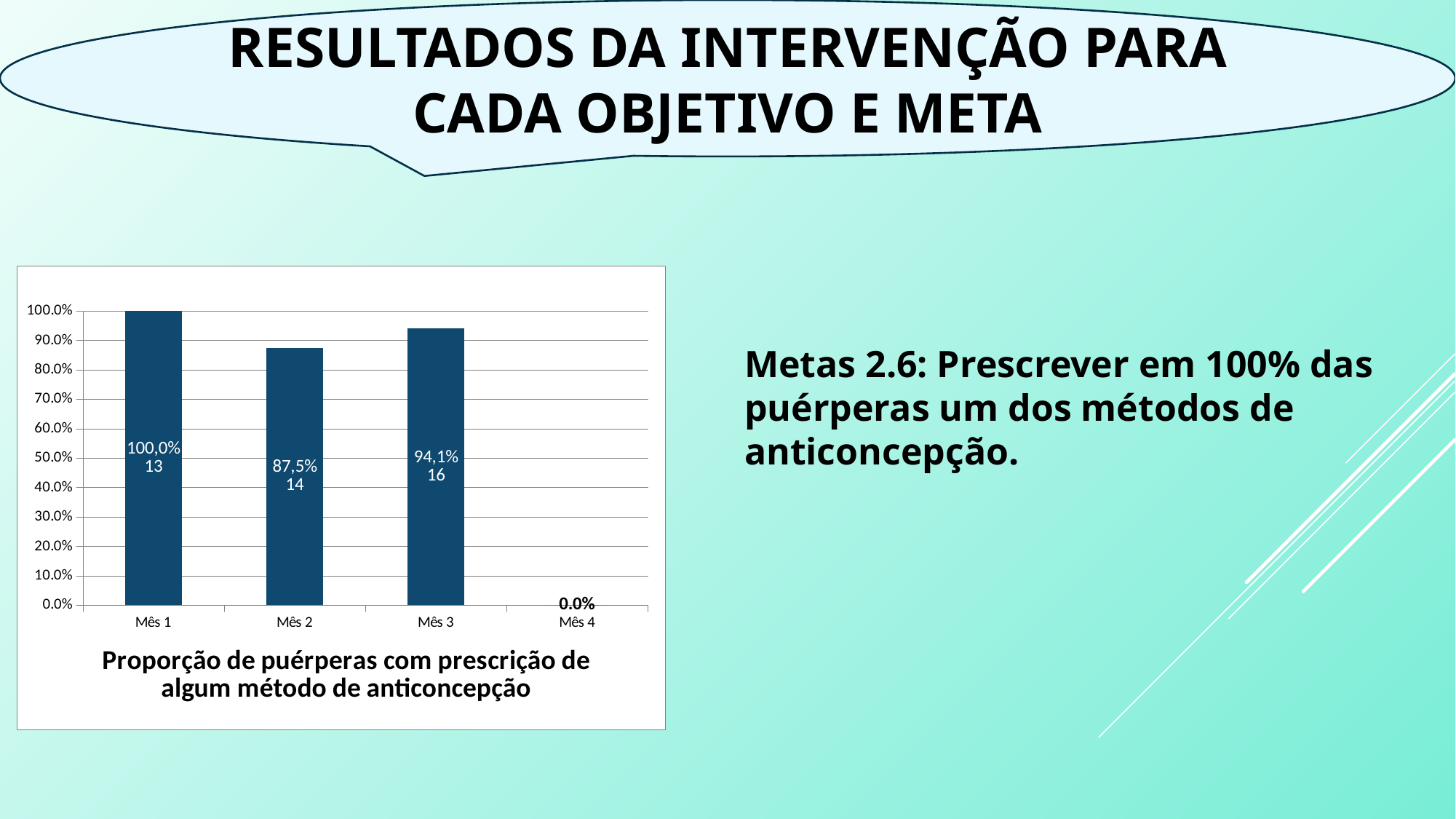
Which month has the lowest value? Mês 4 What is the value for Mês 1? 100,0% How many months are shown on the x axis? 4 What is the value for Mês 2? 87,5% What is the difference between the values for Mês 1 and Mês 2? 12,5% Which is larger, the value for Mês 2 or Mês 3? Mês 3 What is the title of the chart? Proporção de puérperas com prescrição de algum método de anticoncepção What kind of chart is shown? Bar chart Which month has the highest value? Mês 1 What count is printed inside the bar for Mês 2? 14 What is the value for Mês 4? 0.0% What is the value for Mês 3? 94,1%